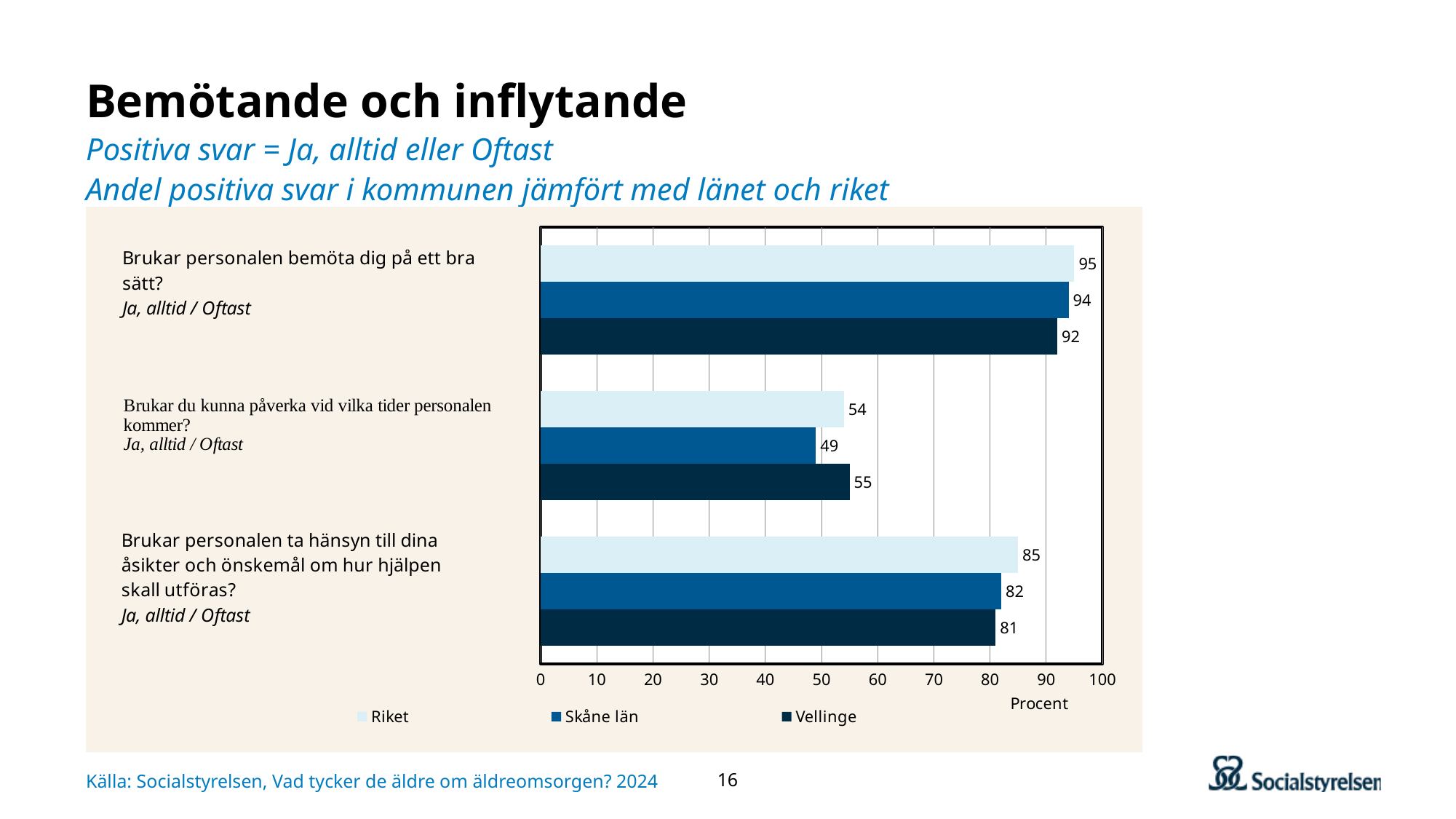
What is the value for Riket on the question "Brukar personalen bemöta dig på ett bra sätt?"? 95 Which series has the lowest value on the question "Brukar du kunna påverka vid vilka tider personalen kommer?"? Skåne län How many questions (categories) are shown in the chart? 3 Is the value for Vellinge higher or lower than the value for Riket on the question "Brukar du kunna påverka vid vilka tider personalen kommer?"? higher What is the value for Skåne län on the question "Brukar personalen ta hänsyn till dina åsikter och önskemål om hur hjälpen skall utföras?"? 82 What is the difference between Riket and Vellinge on the question "Brukar personalen bemöta dig på ett bra sätt?"? 3 What is the difference between Vellinge and Skåne län on the question "Brukar du kunna påverka vid vilka tider personalen kommer?"? 6 How many series does the legend list? 3 What kind of chart is shown on the slide? bar chart Which series has the highest value on the question "Brukar personalen ta hänsyn till dina åsikter och önskemål om hur hjälpen skall utföras?"? Riket What unit is shown on the horizontal axis of the chart? Procent What is the value for Vellinge on the question "Brukar du kunna påverka vid vilka tider personalen kommer?"? 55